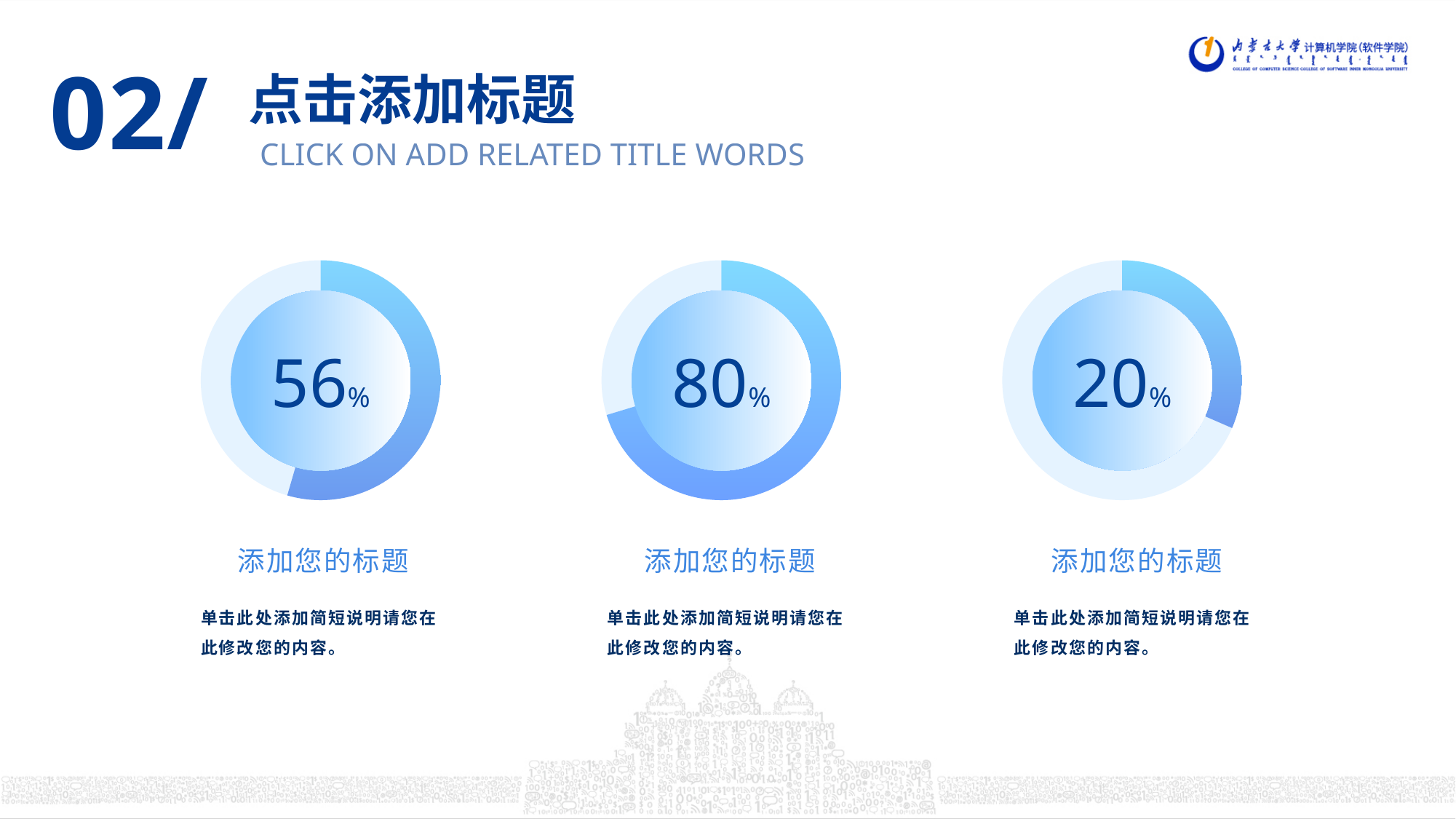
What value is shown in the middle donut chart? 80% Is the value in the left donut chart greater or less than 50%? greater Which of the three donut charts shows the lowest percentage: left, middle or right? right How many donut charts are on the slide? 3 What is the difference between the percentage in the left donut chart and the percentage in the right donut chart? 36% Which shows a larger percentage, the left donut chart or the middle donut chart? the middle donut chart What value is shown in the left donut chart? 56% What is the title text shown below each of the three donut charts? 添加您的标题 What kind of chart is used to display the three percentages on the slide? donut chart What is the difference between the percentage in the middle donut chart and the percentage in the right donut chart? 60% What value is shown in the right donut chart? 20% Which of the three donut charts shows the highest percentage: left, middle or right? middle